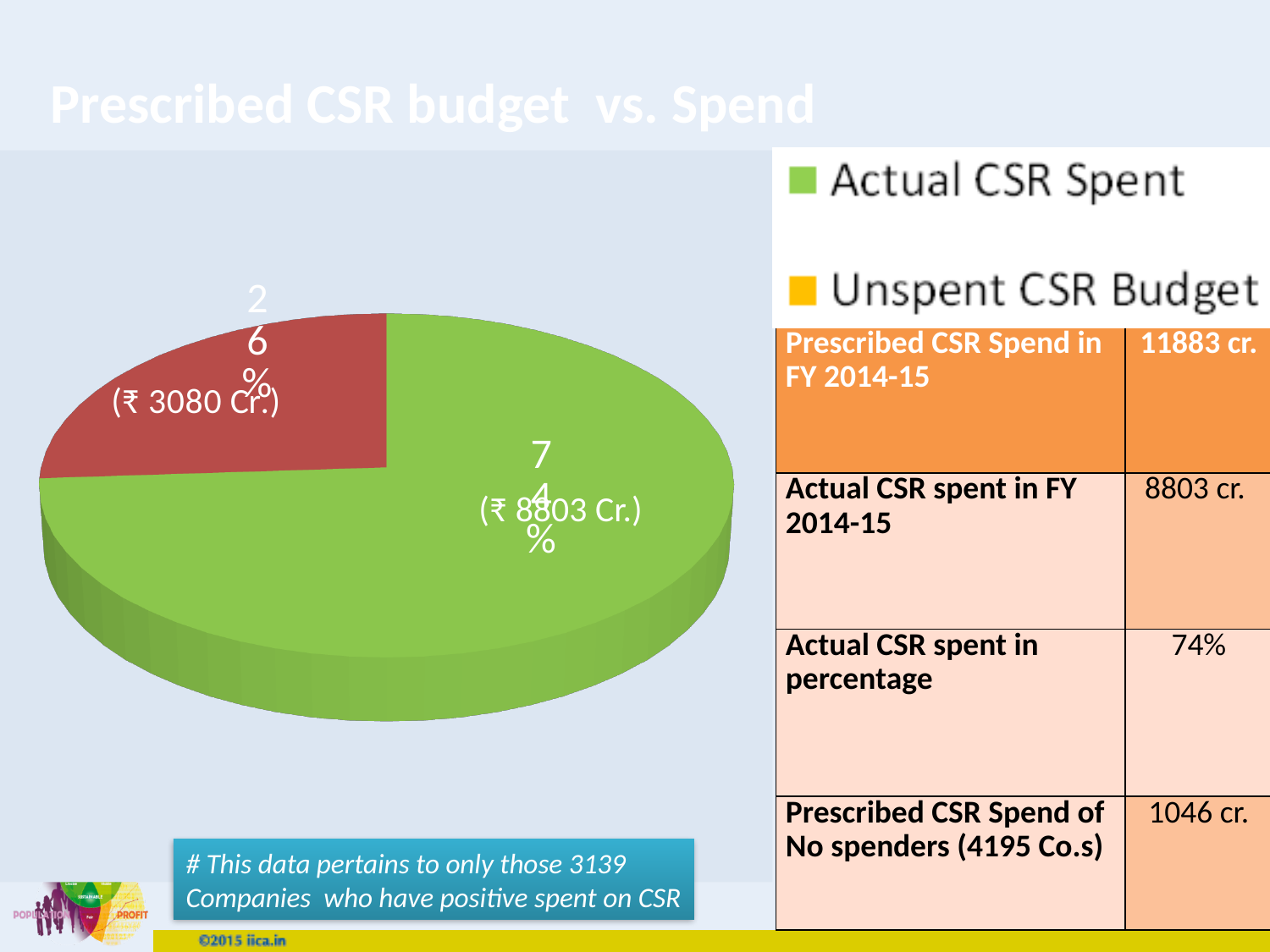
How many slices does the pie chart have? 2 What is the difference in percentage points between the Actual CSR Spent and Unspent CSR Budget slices? 48 Which slice of the pie chart is the smallest? Unspent CSR Budget What percentage of the pie is Actual CSR Spent? 74% What amount is labelled on the Unspent CSR Budget slice of the pie chart? ₹ 3080 Cr. How many entries does the pie chart's legend list? 2 What percentage of the pie is Unspent CSR Budget? 26% Which is larger in the pie chart, Actual CSR Spent or Unspent CSR Budget? Actual CSR Spent Which slice of the pie chart is the largest? Actual CSR Spent What colour is the Actual CSR Spent slice in the pie chart? green What kind of chart is shown on the slide? pie chart What amount is labelled on the Actual CSR Spent slice of the pie chart? ₹ 8803 Cr.